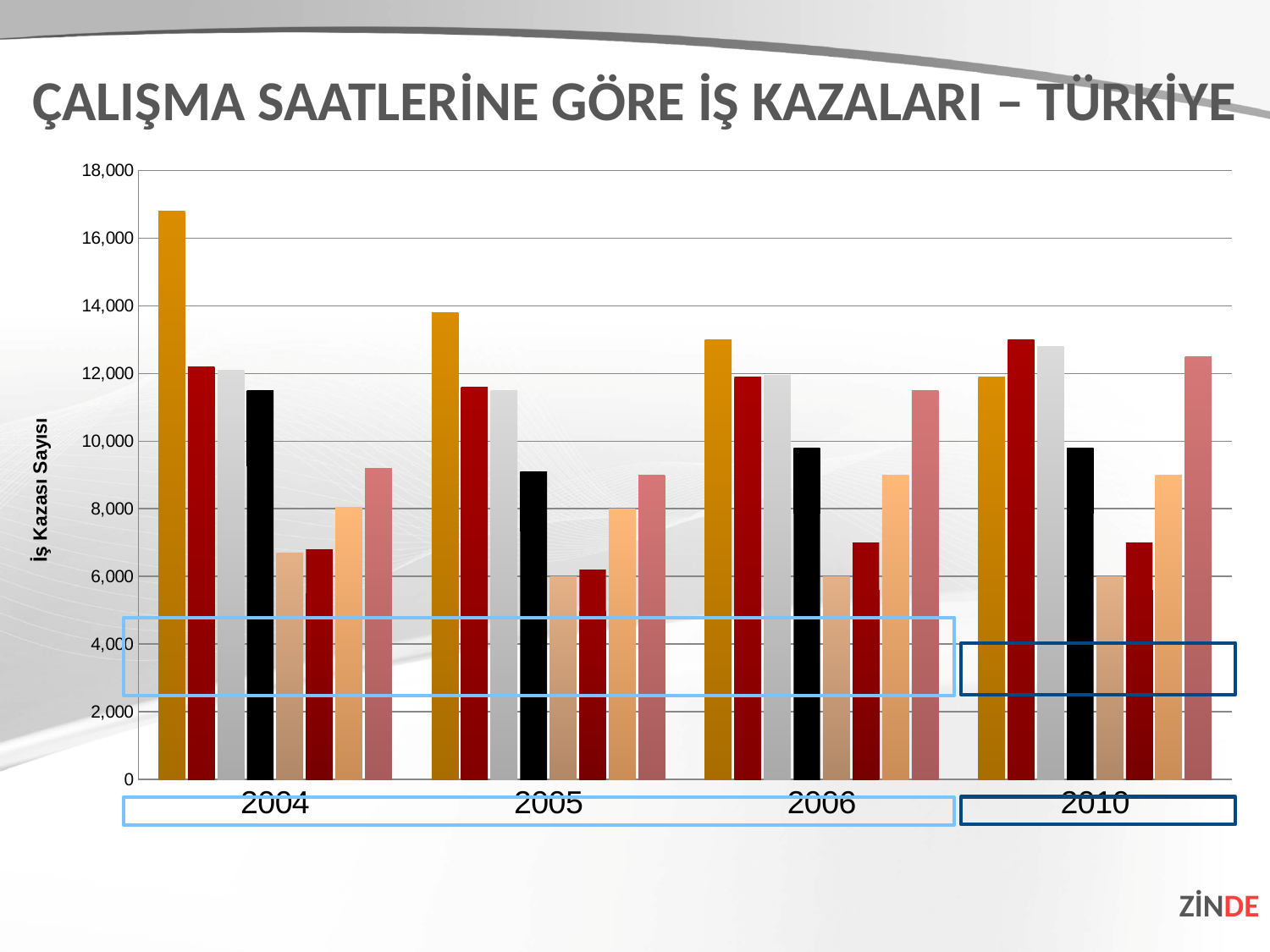
Is the first (orange) bar in 2004 larger or smaller than the first (orange) bar in 2010? larger What is the maximum value shown on the vertical axis? 18,000 Is the first (orange) bar in the 2010 group greater or less than 10,000? greater Which years are shown on the x axis of the chart? 2004, 2005, 2006, 2010 How many bars are plotted for each year group? 8 Is the tallest bar in the 2005 group greater or less than 12,000? greater Is the shortest bar in the 2006 group greater or less than 8,000? less How many year categories are shown on the x axis? 4 Which year contains the tallest bar in the chart? 2004 What is the label of the vertical axis? İş Kazası Sayısı What kind of chart is shown on the slide? bar chart